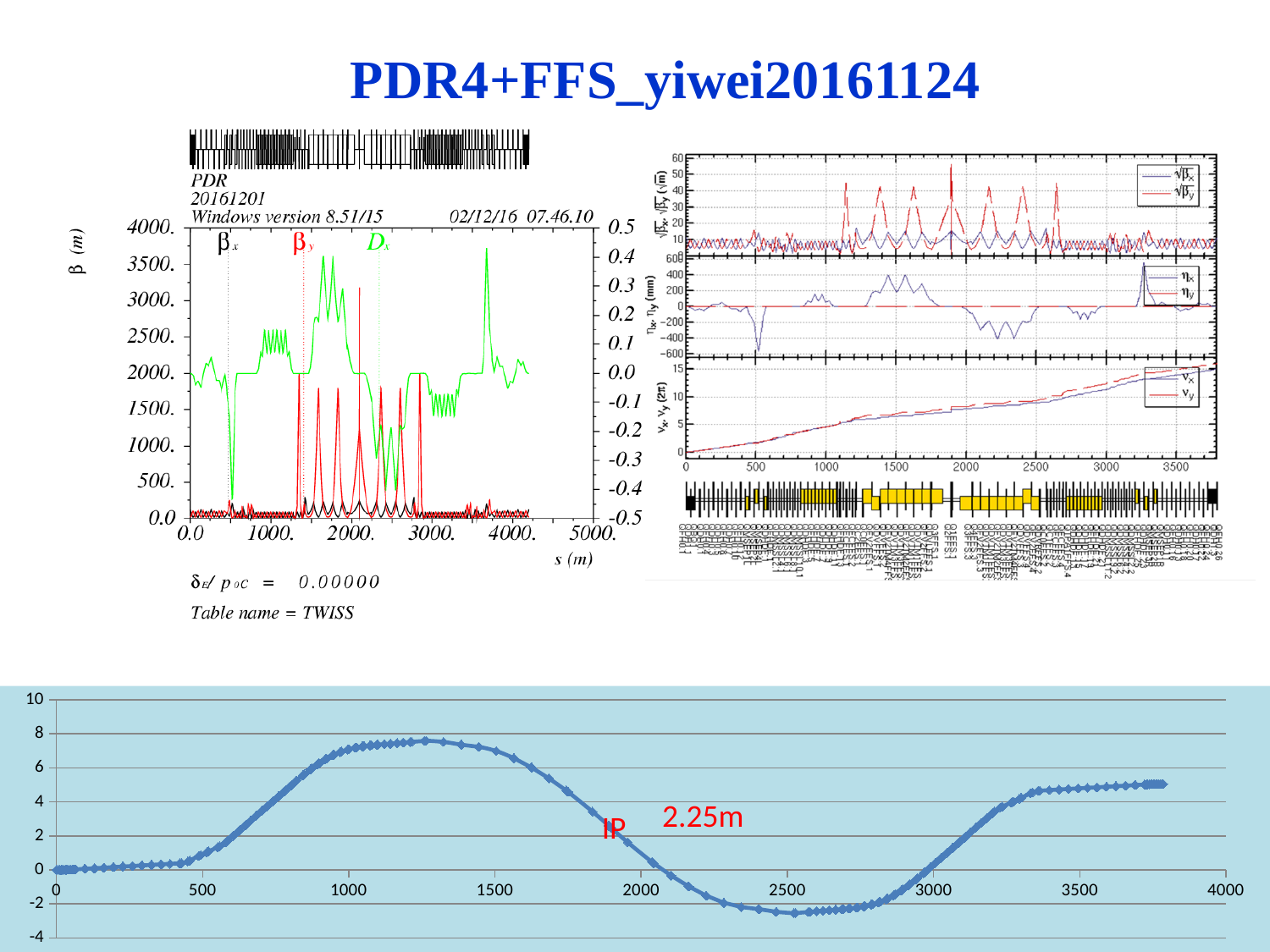
In the bottom chart, do the values rise or fall between s = 500 and s = 1250? rise In the top-left TWISS chart, what is the maximum value shown on the left vertical axis? 4000. In the top-right chart, in the bottom panel showing νx and νy, do the values rise or fall along the horizontal axis? rise In the bottom chart, is the value at s = 3750 greater or less than 4? greater What kind of chart is the bottom chart on the slide? line chart In the top-left TWISS chart, how many series are labelled in the plot? 3 In the bottom chart, is the value at s = 1250 greater or less than 6? greater In the bottom chart, is the value at s = 2500 greater or less than 0? less In the bottom chart, do the values rise or fall between s = 1500 and s = 2500? fall In the bottom chart, what value is annotated in red next to the IP label? 2.25m In the top-left TWISS chart, what is the label of the horizontal axis? s (m)